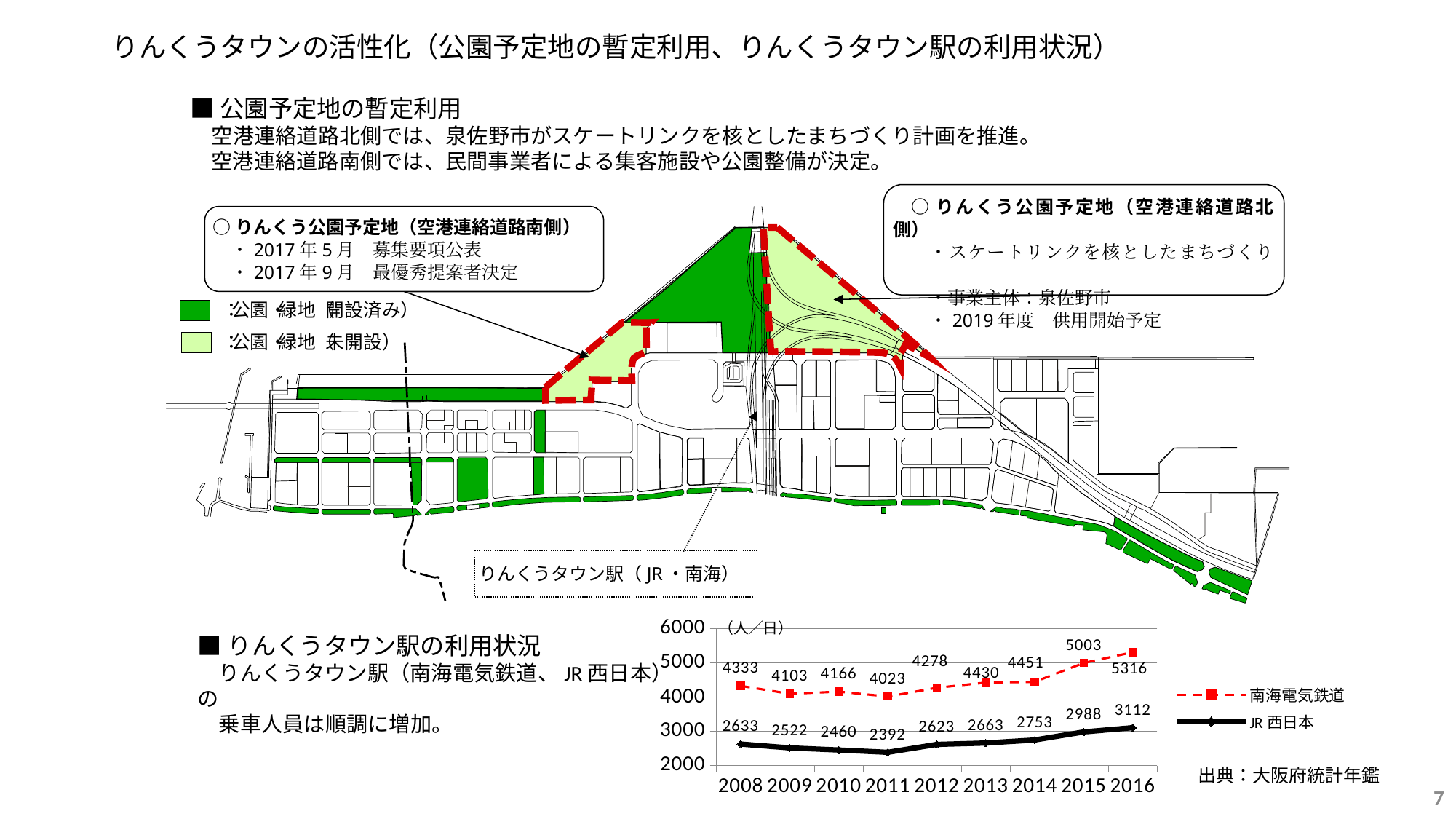
折れ線グラフで、2012年の南海電気鉄道とJR西日本では、どちらの値が大きいですか？ 南海電気鉄道 折れ線グラフで、2011年のJR西日本の乗車人員の値はいくつですか？ 2392 スライド下部のグラフはどの種類のグラフですか？ 折れ線グラフ 折れ線グラフのx軸には、いくつの年が示されていますか？ 9 折れ線グラフで、2011年から2016年にかけてJR西日本の値は増加していますか、減少していますか？ 増加 折れ線グラフで、2015年のJR西日本の値と2014年のJR西日本の値の差はいくつですか？ 235 折れ線グラフで、2016年の南海電気鉄道の乗車人員の値はいくつですか？ 5316 折れ線グラフで、JR西日本の値が最も高い年はどれですか？ 2016 折れ線グラフで、2008年の南海電気鉄道の値はいくつですか？ 4333 折れ線グラフで、2016年の南海電気鉄道とJR西日本の値の差はいくつですか？ 2204 折れ線グラフの凡例には、いくつの系列が示されていますか？ 2 折れ線グラフで、南海電気鉄道の値が最も低い年はどれですか？ 2011